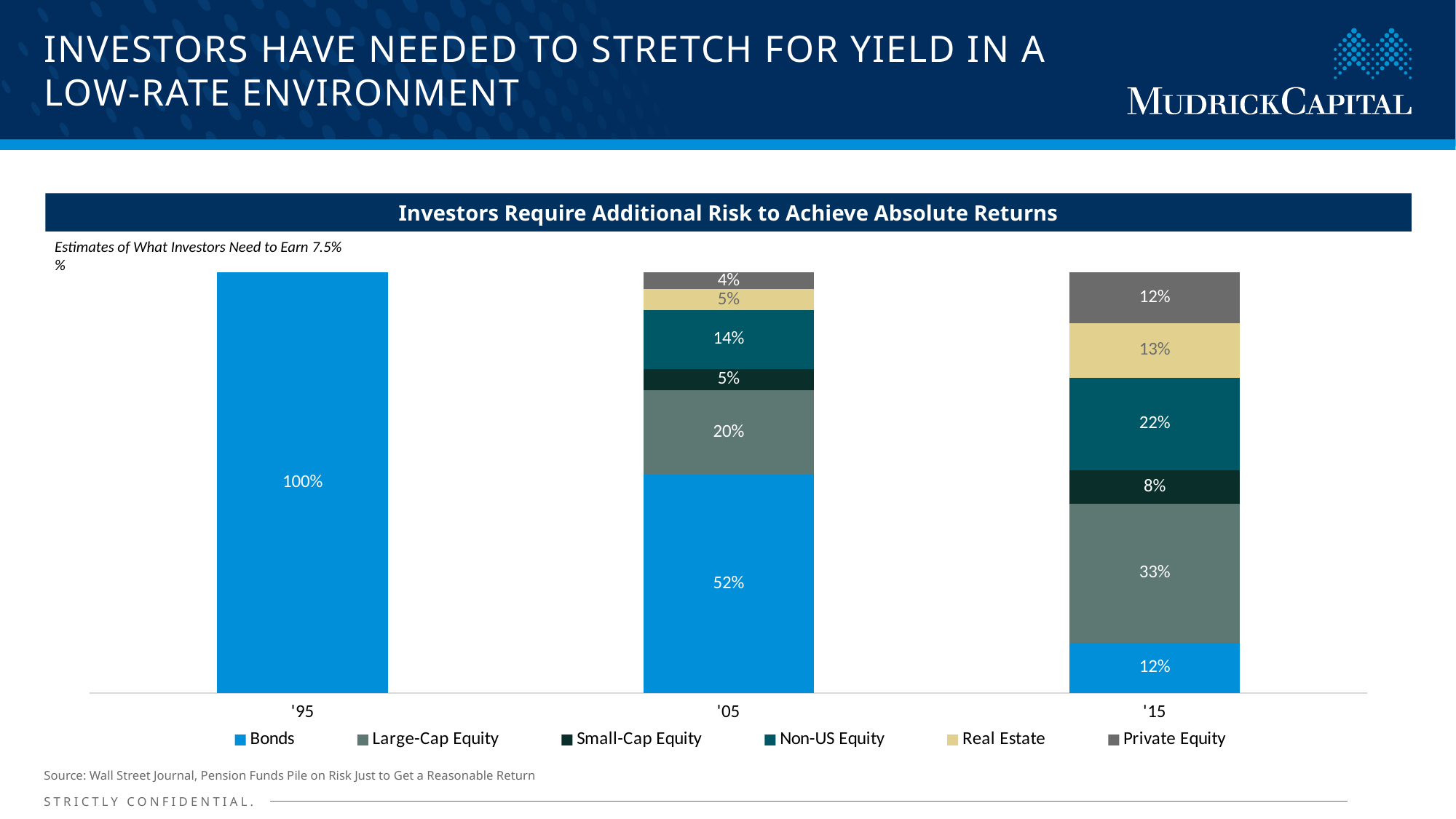
What is the Bonds value for '05? 52% What is the Large-Cap Equity value for '15? 33% Does the Bonds value rise or fall from '95 to '15? Fall Which is larger, the Real Estate value for '05 or the Real Estate value for '15? '15 What is the difference between the Bonds value for '05 and the Bonds value for '15? 40% How many years are shown on the x axis? 3 Which year has the lowest Bonds value? '15 What is the Private Equity value for '15? 12% What is the Non-US Equity value for '05? 14% What kind of chart is shown? Stacked bar chart How many series does the legend list? 6 What is the Bonds value for '95? 100%